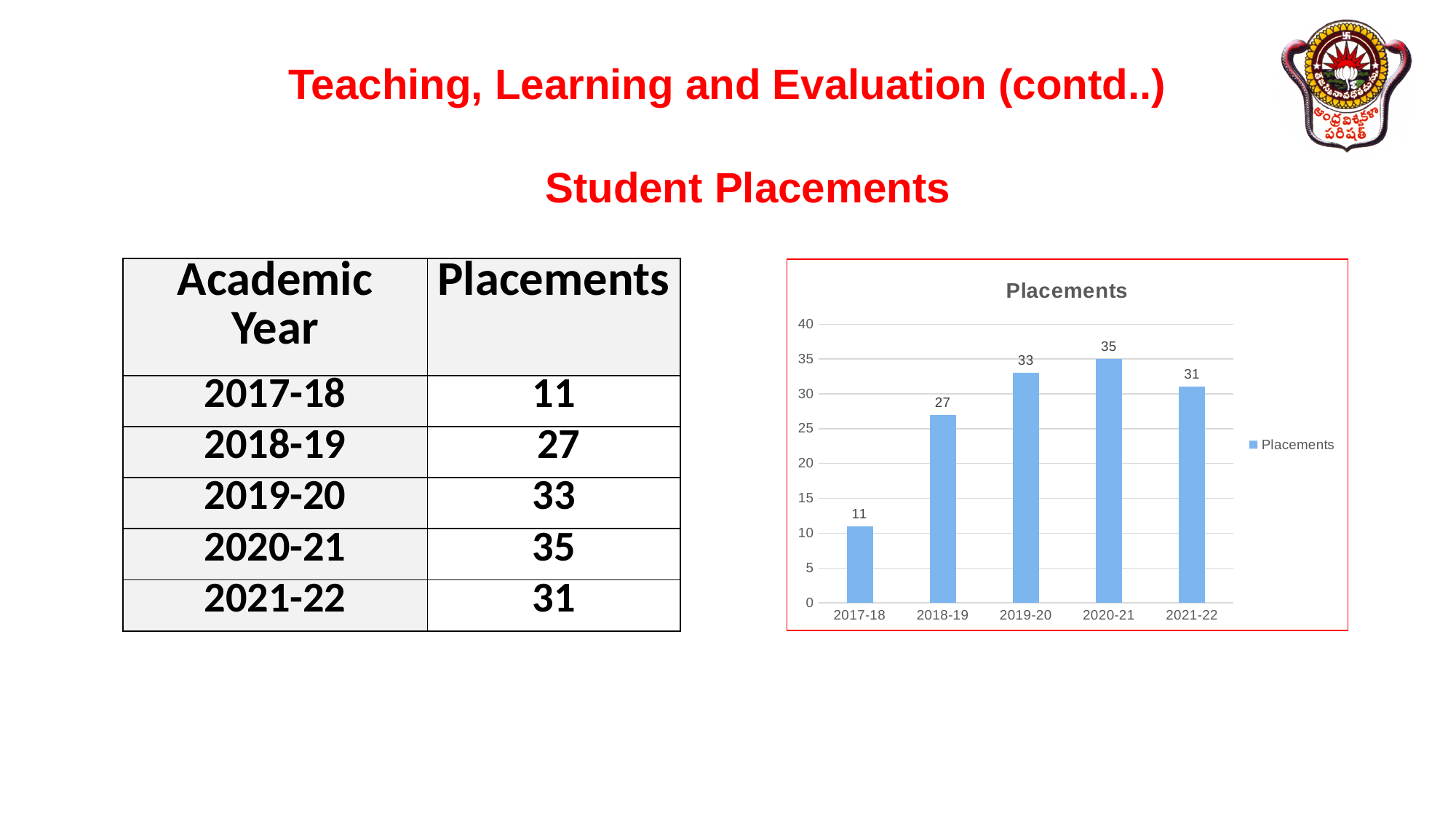
Which academic year has the lowest number of placements in the chart? 2017-18 How many academic years are shown on the x axis of the chart? 5 What is the value for 2021-22 in the Placements chart? 31 What kind of chart is shown on the slide? bar chart Which academic year has the highest number of placements in the chart? 2020-21 What is the difference between the placements for 2018-19 and 2021-22? 4 Is the value for 2018-19 greater or less than 30? less What is the value for 2019-20 in the Placements chart? 33 What is the difference between the placements for 2020-21 and 2017-18? 24 How many series does the chart legend list? 1 Which is larger, the placements for 2019-20 or 2021-22? 2019-20 What is the value for 2017-18 in the Placements chart? 11